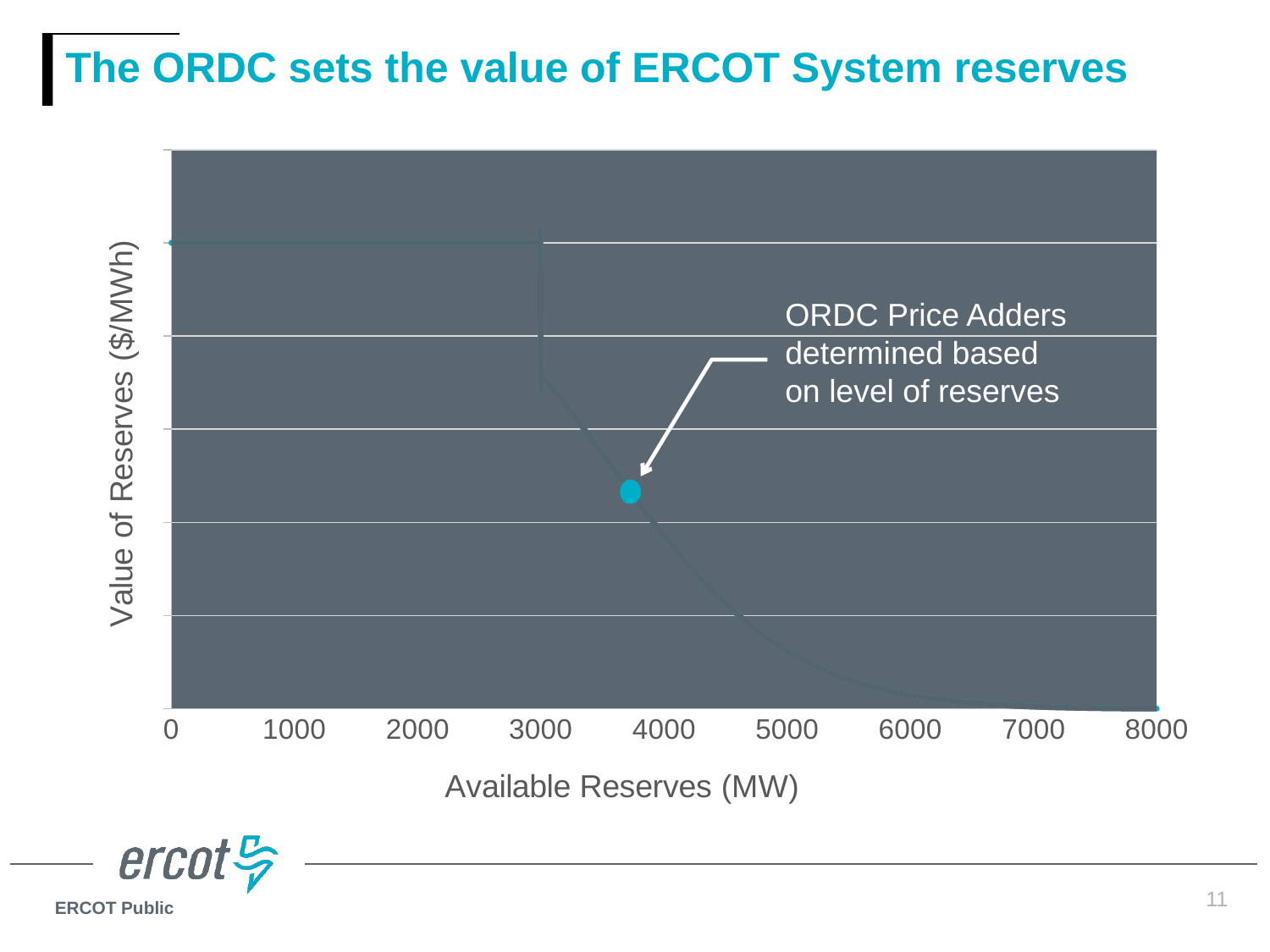
How many tick labels are shown on the x axis? 9 As available reserves increase along the x axis, does the value of reserves rise or fall? fall What kind of chart is shown on the slide? line chart What does the annotation with the arrow pointing to the highlighted point say? ORDC Price Adders determined based on level of reserves What is the title of the x axis? Available Reserves (MW) What is the highest value shown on the x axis? 8000 Which is larger: the value of reserves at 4000 MW or at 7000 MW of available reserves? 4000 MW Is the highlighted point on the curve at an available reserves level greater or less than 3000 MW? greater Is the highlighted point on the curve at an available reserves level greater or less than 4000 MW? less Which is larger: the value of reserves at 1000 MW or at 5000 MW of available reserves? 1000 MW